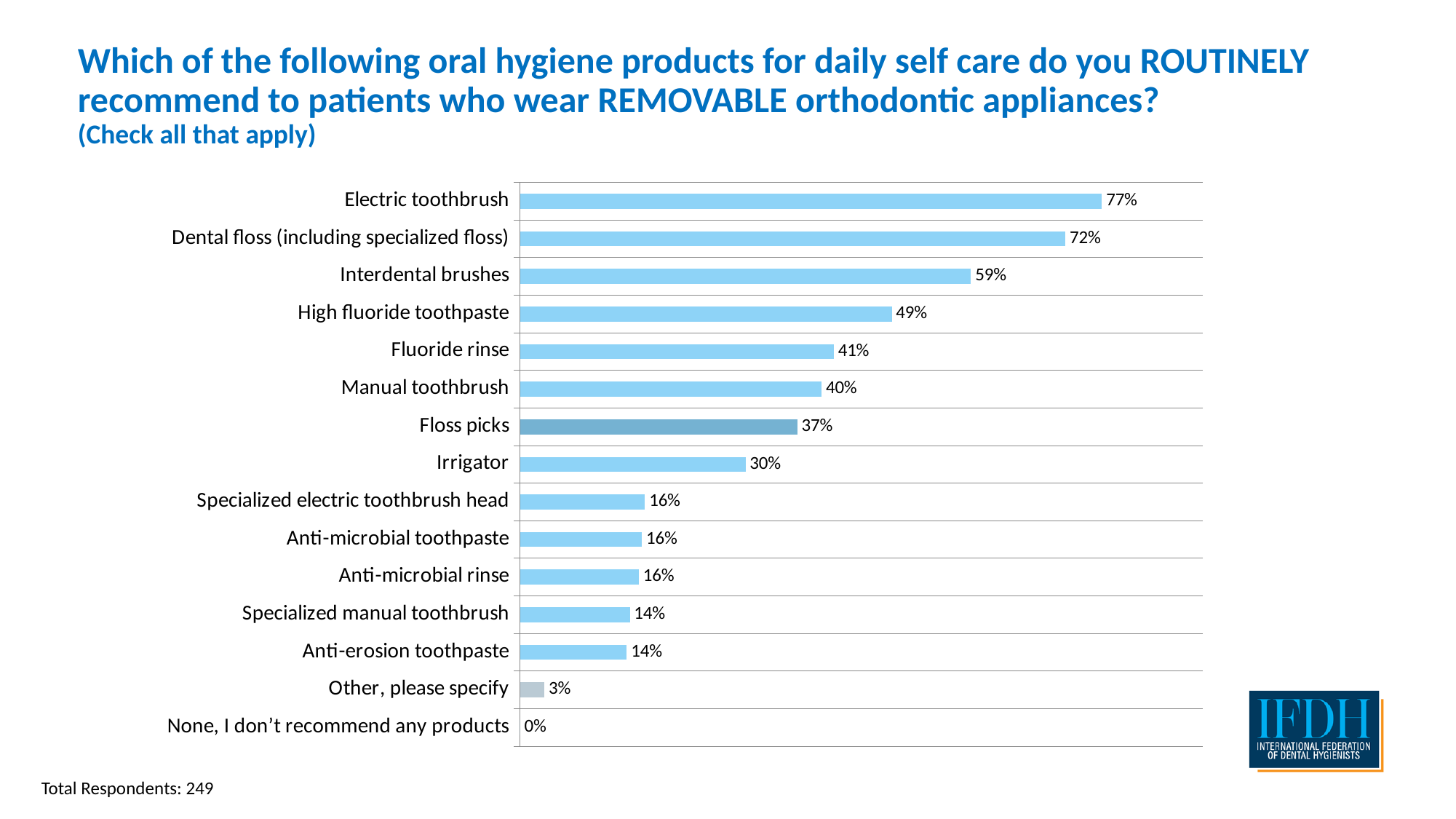
Which is larger, the value for Fluoride rinse or the value for Manual toothbrush? Fluoride rinse What is the value for Irrigator? 30% What is the value for Other, please specify? 3% What is the difference between the values for Dental floss (including specialized floss) and Interdental brushes? 13% What is the difference between the values for High fluoride toothpaste and Anti-erosion toothpaste? 35% What percentage of respondents routinely recommend an electric toothbrush? 77% Which category has the lowest percentage? None, I don't recommend any products Which product has the highest percentage? Electric toothbrush What kind of chart is shown on the slide? Bar chart How many total respondents are noted on the slide? 249 What is the value for Floss picks? 37% How many categories are shown in the chart? 15